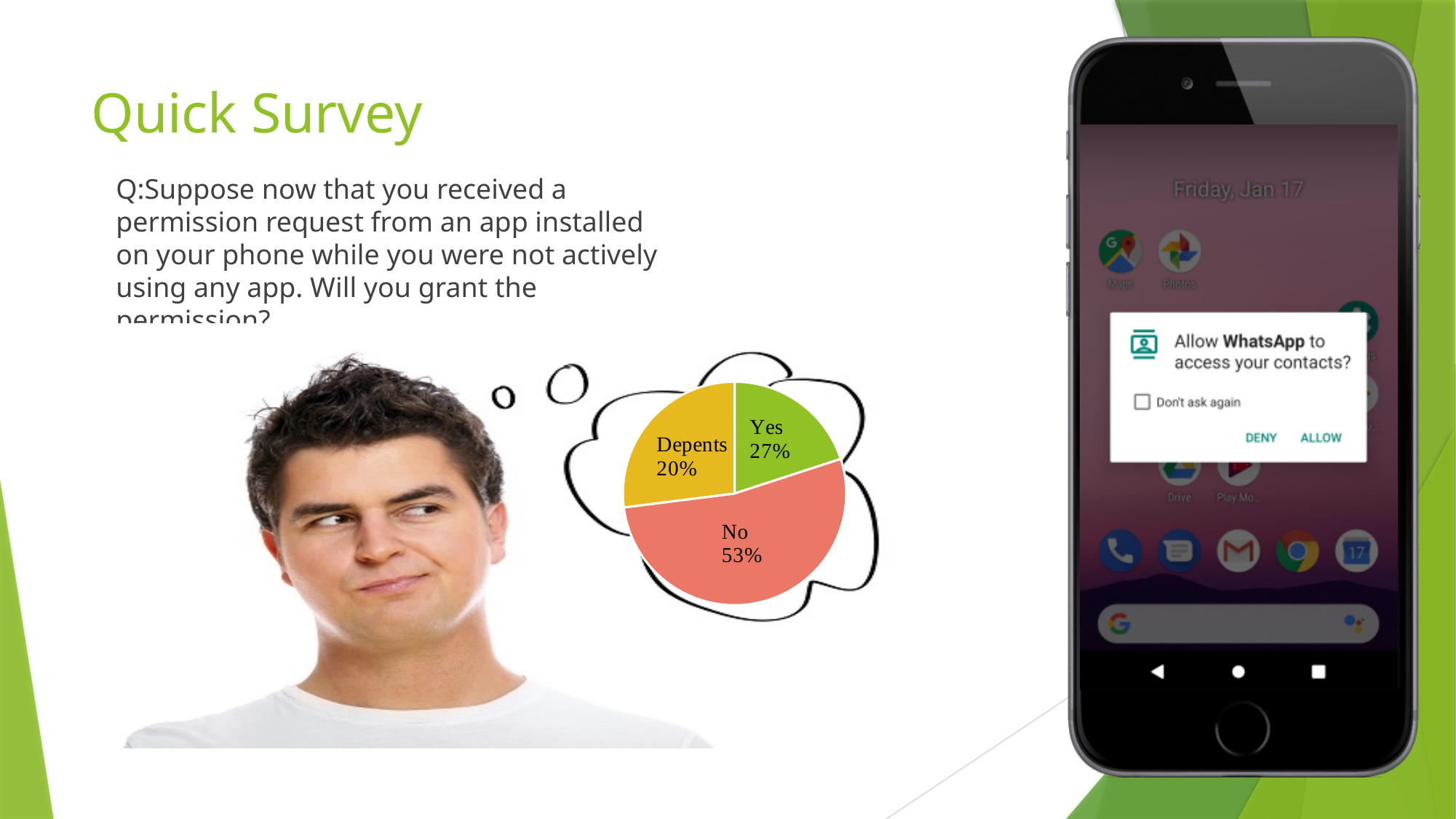
What colour is the "Yes" slice of the pie chart? green What colour is the "No" slice of the pie chart? red What percentage of respondents answered "No"? 53% Which response has the smallest share of the pie? Depents What is the difference in percentage points between "No" and "Yes"? 26 What kind of chart is shown inside the thought bubble? pie chart What percentage of respondents answered "Yes"? 27% How many slices does the pie chart have? 3 What percentage of respondents answered "Depents"? 20% What is the difference in percentage points between "Yes" and "Depents"? 7 Which is larger, the share for "Yes" or the share for "Depents"? Yes Which response has the largest share of the pie? No